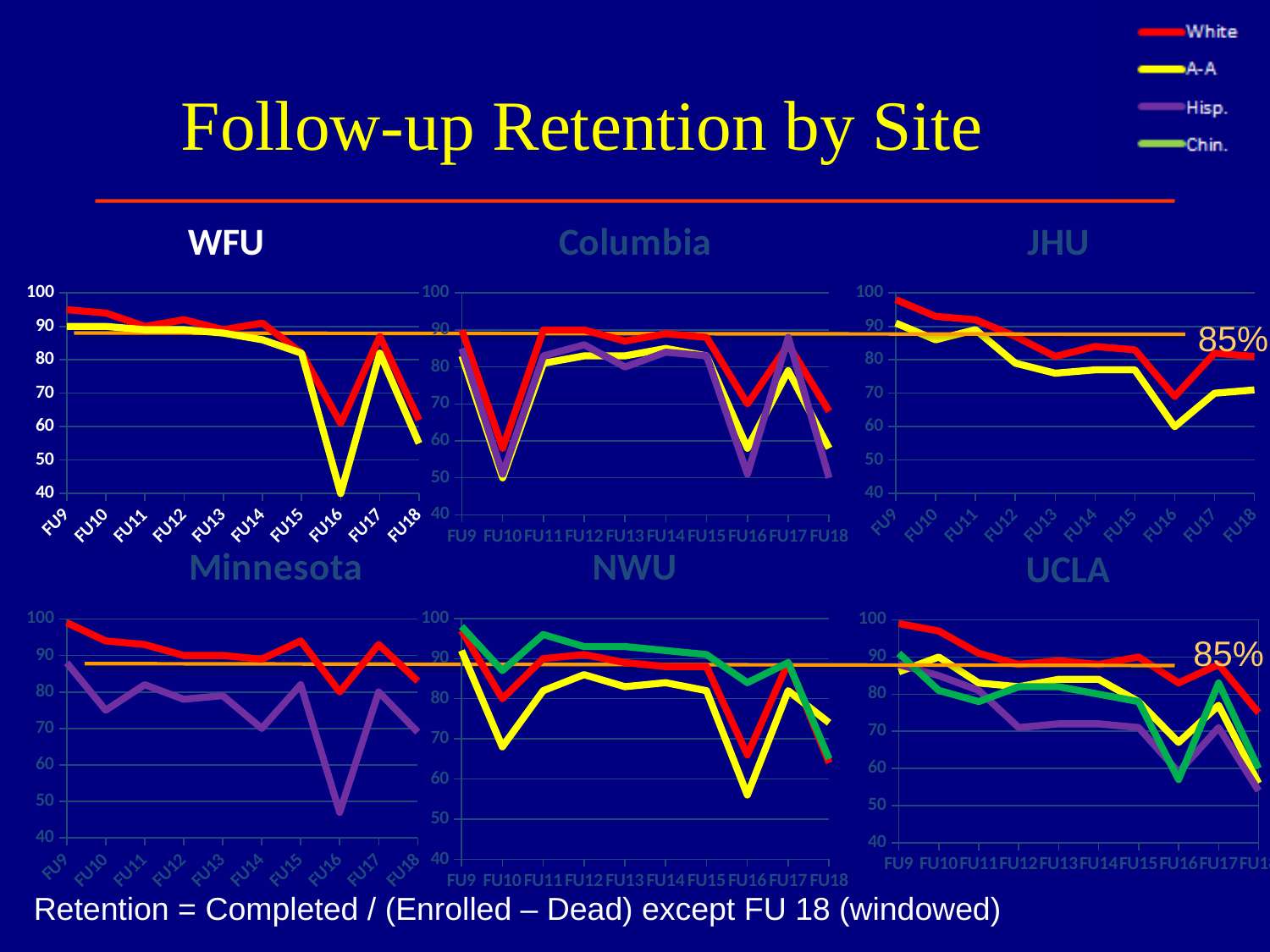
In the Columbia chart, is the White value at FU10 greater or less than 70? less In the NWU chart, which series is higher at FU16, Chin. or A-A? Chin. What value is marked by the horizontal reference line labelled on the JHU and UCLA charts? 85% In the JHU chart, is the A-A value at FU16 greater or less than 70? less In the WFU chart, how many follow-up points are shown along the x axis? 10 In the Minnesota chart, is the Hisp. value at FU16 greater or less than 60? less What kind of chart is used for each site on this slide? Line chart How many site charts are shown on the slide? 6 In the Minnesota chart, which series is higher at FU9, White or Hisp.? White How many series does the legend in the top right list? 4 In the JHU chart, does the White line generally rise or fall from FU9 to FU18? fall